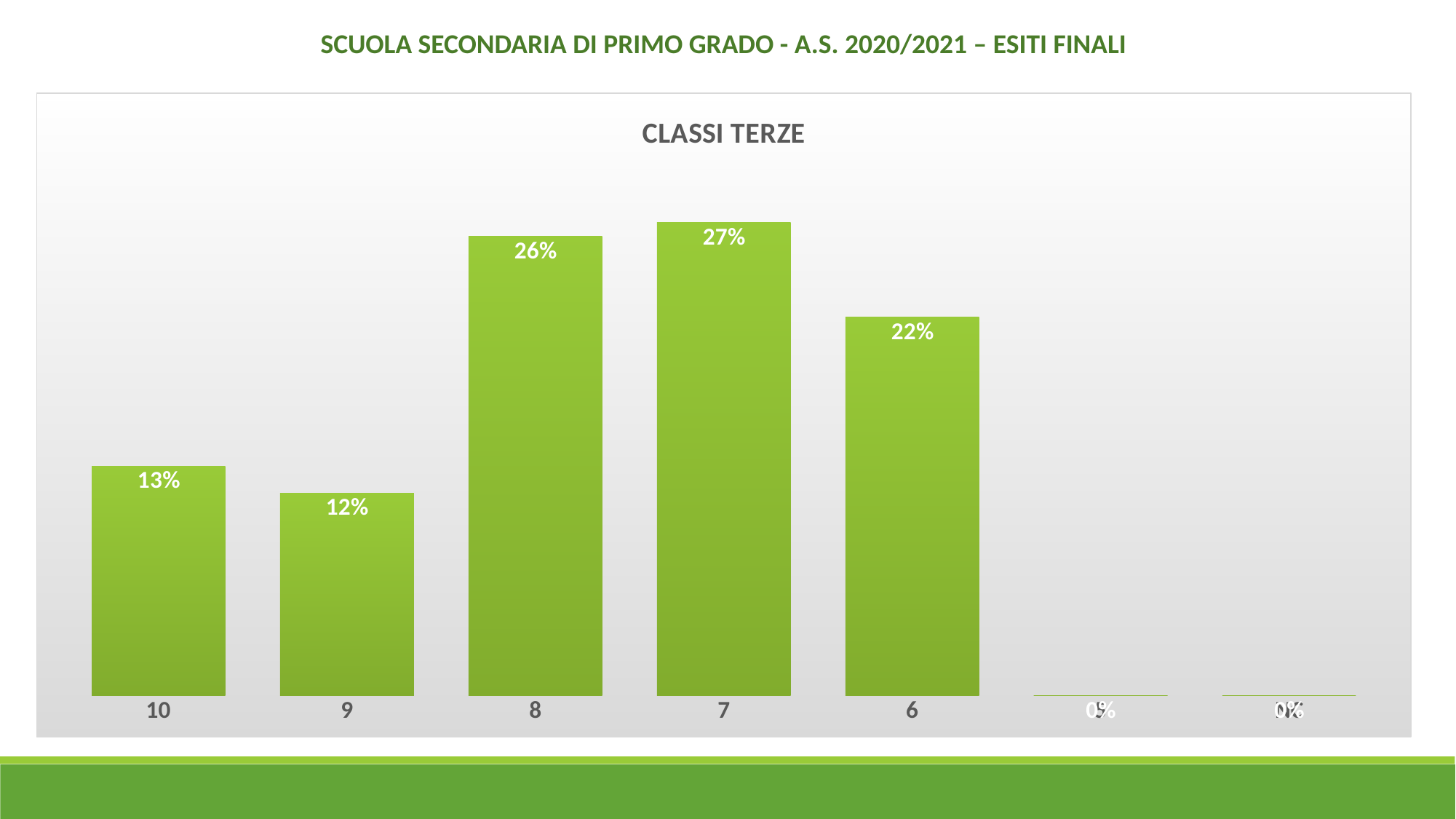
What is the total of the values for grades 10, 9, 8, 7 and 6 in the CLASSI TERZE chart? 100% Which is larger in the CLASSI TERZE chart, the value for grade 10 or grade 9? 10 Among grades 10, 9, 8, 7 and 6, which has the lowest percentage in the CLASSI TERZE chart? 9 What is the title of the chart on the slide? CLASSI TERZE What is the value for grade 10 in the CLASSI TERZE chart? 13% What kind of chart is shown on the slide? Bar chart What is the difference between the values for grade 8 and grade 9 in the CLASSI TERZE chart? 14% What is the value for grade 7 in the CLASSI TERZE chart? 27% What is the value for grade 9 in the CLASSI TERZE chart? 12% What is the difference between the values for grade 7 and grade 8 in the CLASSI TERZE chart? 1% Which grade has the highest percentage in the CLASSI TERZE chart? 7 What is the value for grade 6 in the CLASSI TERZE chart? 22%